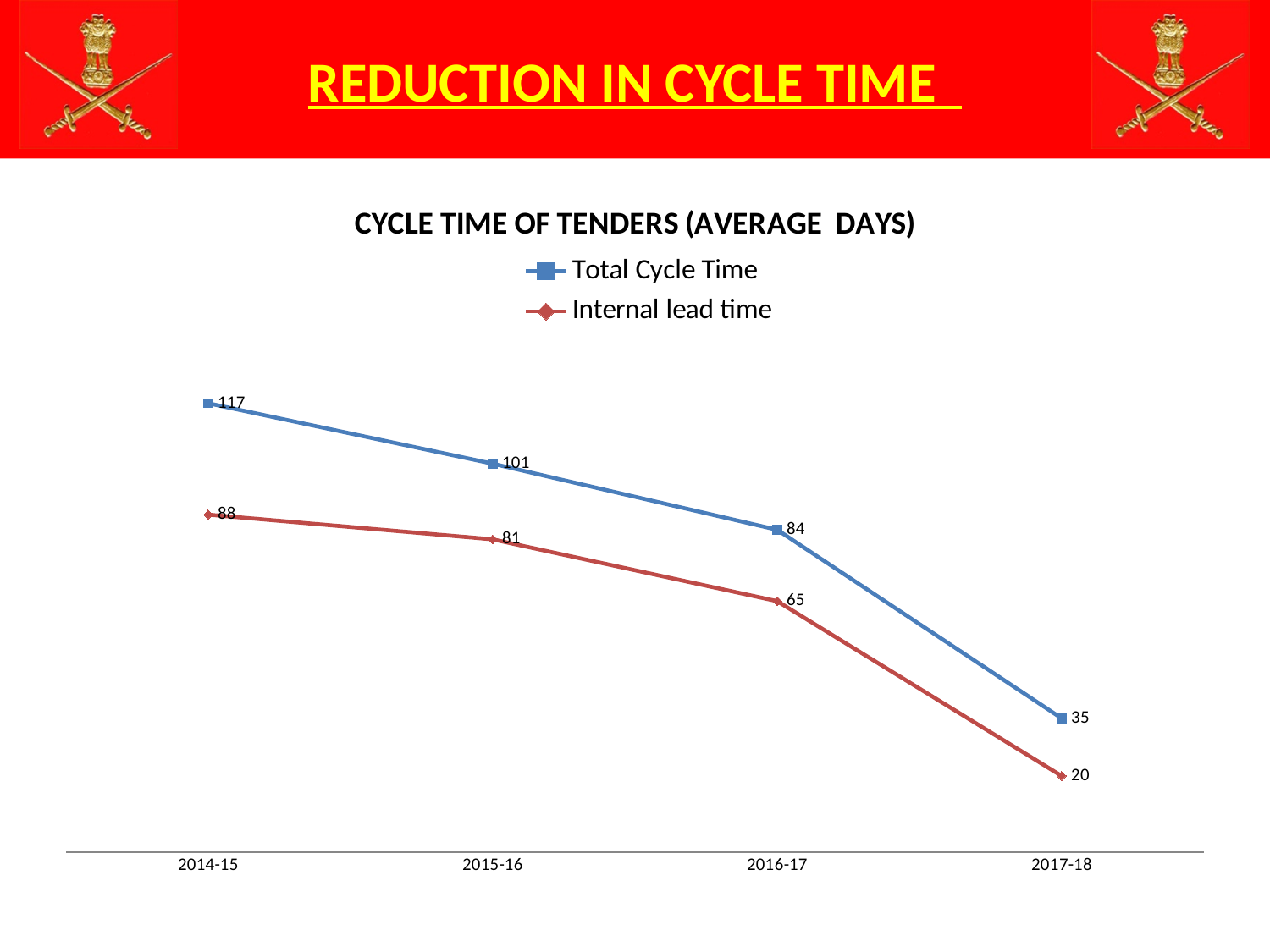
In which year is the Total Cycle Time highest? 2014-15 In which year is the Internal lead time lowest? 2017-18 By how much did the Total Cycle Time fall from 2014-15 to 2017-18? 82 How many series does the legend list? 2 How many years are shown on the x axis? 4 What kind of chart is shown? Line chart What is the Internal lead time value for 2016-17? 65 What is the difference between Total Cycle Time and Internal lead time in 2016-17? 19 Which is larger in 2015-16, the Total Cycle Time or the Internal lead time? Total Cycle Time What is the Total Cycle Time value for 2017-18? 35 What is the Total Cycle Time value for 2014-15? 117 What is the Internal lead time value for 2015-16? 81